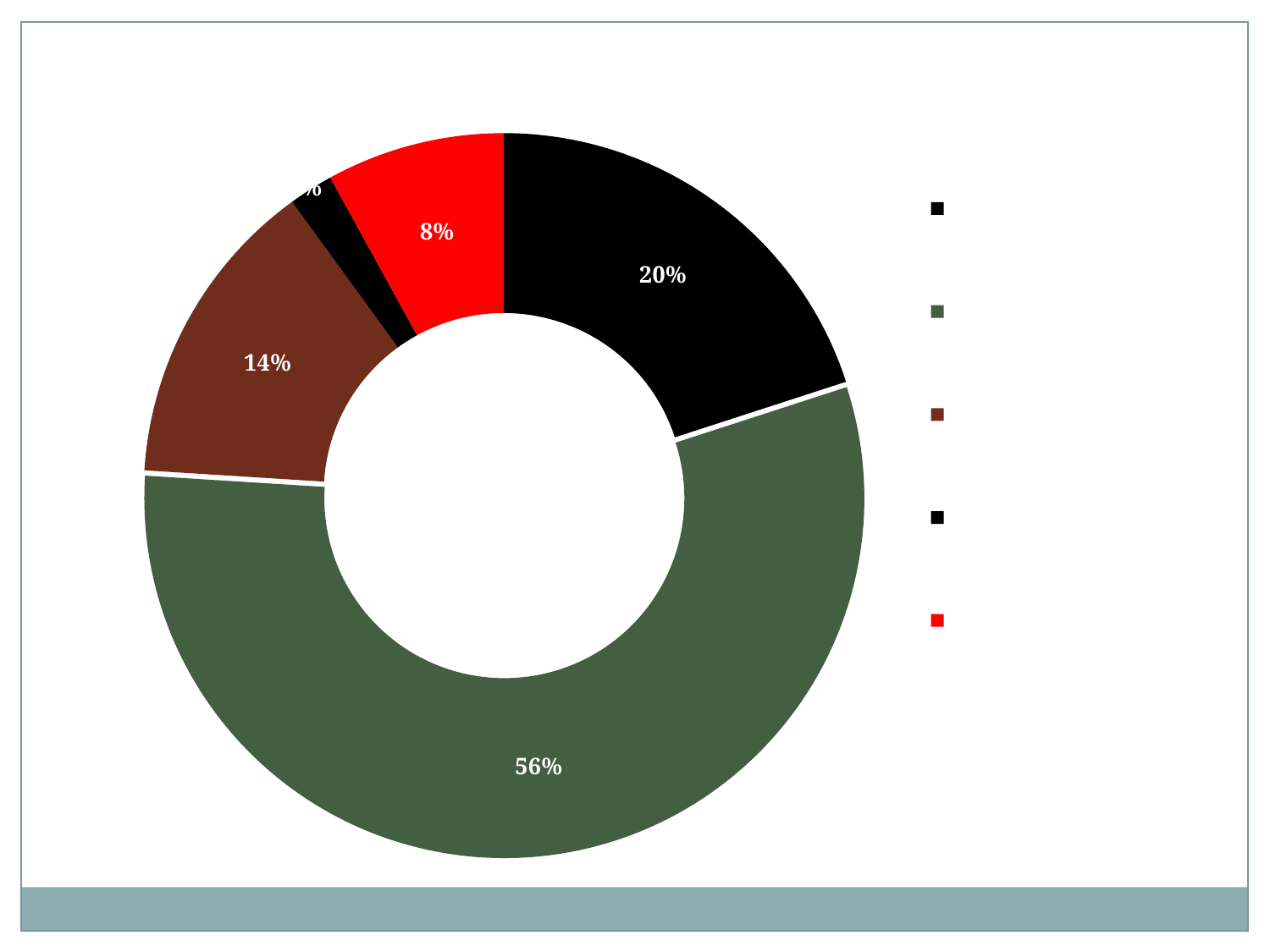
What percentage is shown on the large black slice at the top right? 20% What percentage is shown on the brown slice? 14% What percentage is shown on the dark green slice? 56% What percentage is shown on the red slice? 8% What kind of chart is shown on the slide? Doughnut (pie) chart What is the difference in percentage points between the dark green slice and the large black slice? 36 percentage points How many slices does the doughnut chart have? 5 How many entries does the legend list? 5 Which slice has the largest share of the doughnut? The dark green slice (56%) Which is larger, the large black slice or the brown slice? The large black slice (20%) Which slice has the smallest share of the doughnut? The thin black slice between the brown and red slices What colour is the slice labelled 8%? Red